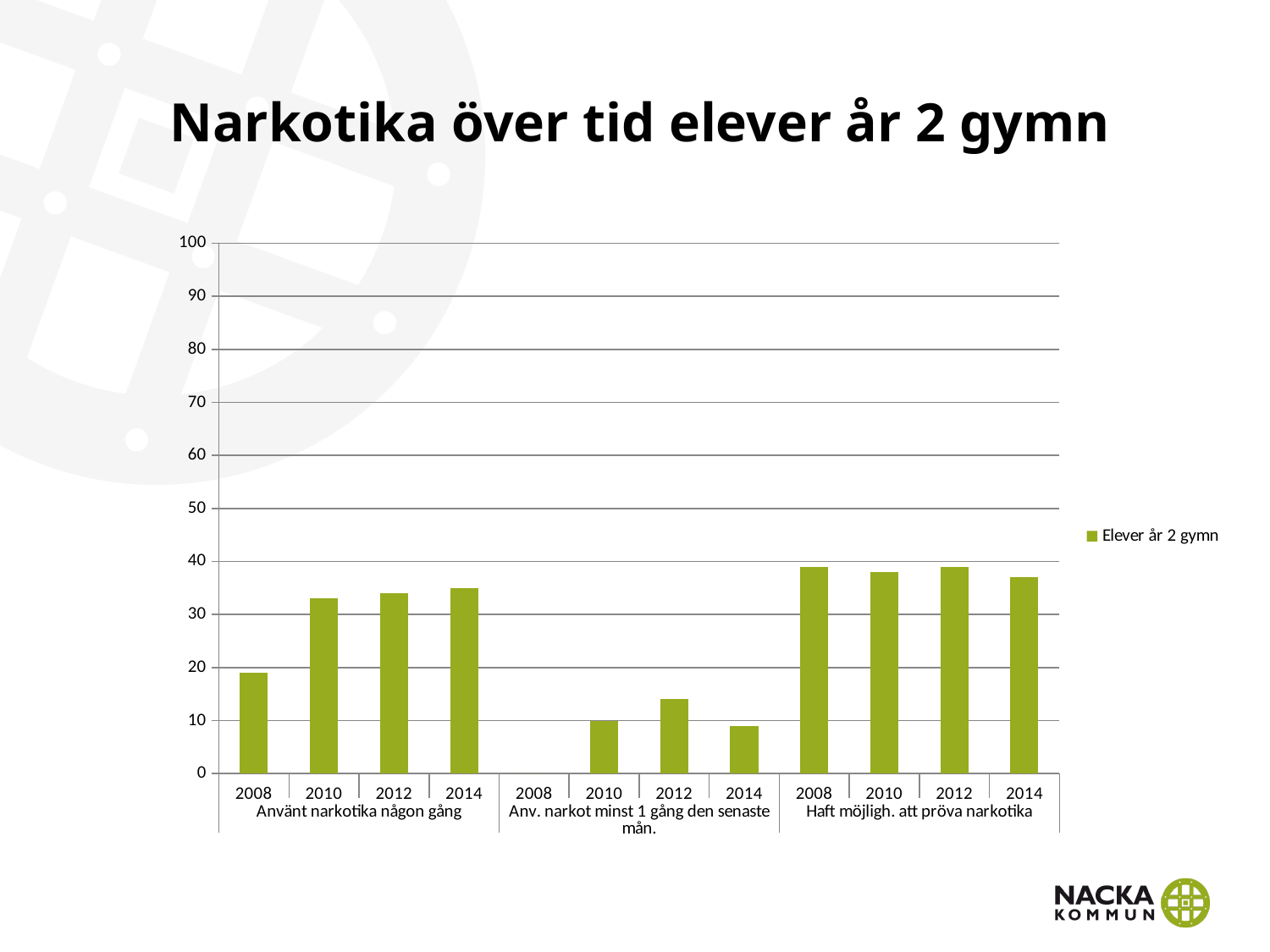
Is the value for 2014 under 'Använt narkotika någon gång' greater or less than 30? greater What kind of chart is shown on the slide? Bar chart Is the value for 2014 under 'Haft möjligh. att pröva narkotika' greater or less than 30? greater What is the title of the chart? Narkotika över tid elever år 2 gymn How many years are shown within each category group? 4 What is the name of the series in the legend? Elever år 2 gymn Which year has the lowest value within the 'Använt narkotika någon gång' group? 2008 Is the value for 2008 under 'Använt narkotika någon gång' greater or less than 10? greater How many category groups are shown along the x axis? 3 How many series does the legend list? 1 Which year has the highest value within the 'Anv. narkot minst 1 gång den senaste mån.' group? 2012